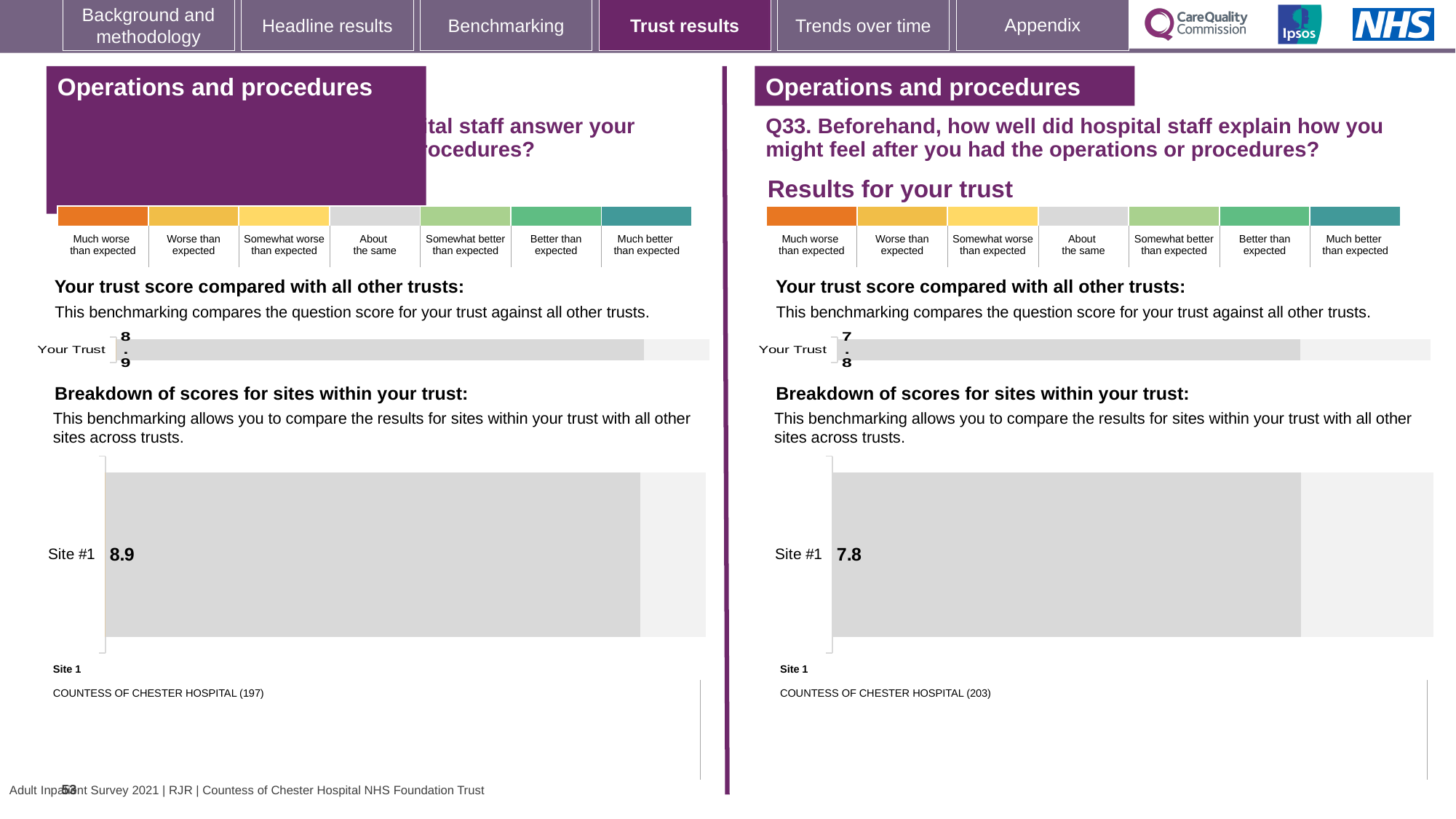
On the right half of the slide (Q33), what is the score shown for Your Trust in the 'Your trust score compared with all other trusts' chart? 7.8 On the left half of the slide, what score is shown for Site #1 in the 'Breakdown of scores for sites within your trust' chart? 8.9 On the left half of the slide, what is the name of Site 1 listed below the site breakdown chart? COUNTESS OF CHESTER HOSPITAL (197) On the left half of the slide, what is the score shown for Your Trust in the 'Your trust score compared with all other trusts' chart? 8.9 What kind of chart is used to show the Your Trust score on the left half of the slide? Bar chart What kind of chart is used to show the Site #1 score on the right half of the slide (Q33)? Bar chart What is the difference between the Your Trust score on the left half of the slide and the Your Trust score on the right half (Q33)? 1.1 How many sites are shown in the 'Breakdown of scores for sites within your trust' chart on the left half of the slide? 1 Which is larger: the Site #1 score on the left half of the slide or the Site #1 score on the right half (Q33)? Left half (8.9) How many sites are shown in the 'Breakdown of scores for sites within your trust' chart on the right half of the slide (Q33)? 1 On the right half of the slide (Q33), what is the name of Site 1 listed below the site breakdown chart? COUNTESS OF CHESTER HOSPITAL (203) On the right half of the slide (Q33), what score is shown for Site #1 in the 'Breakdown of scores for sites within your trust' chart? 7.8